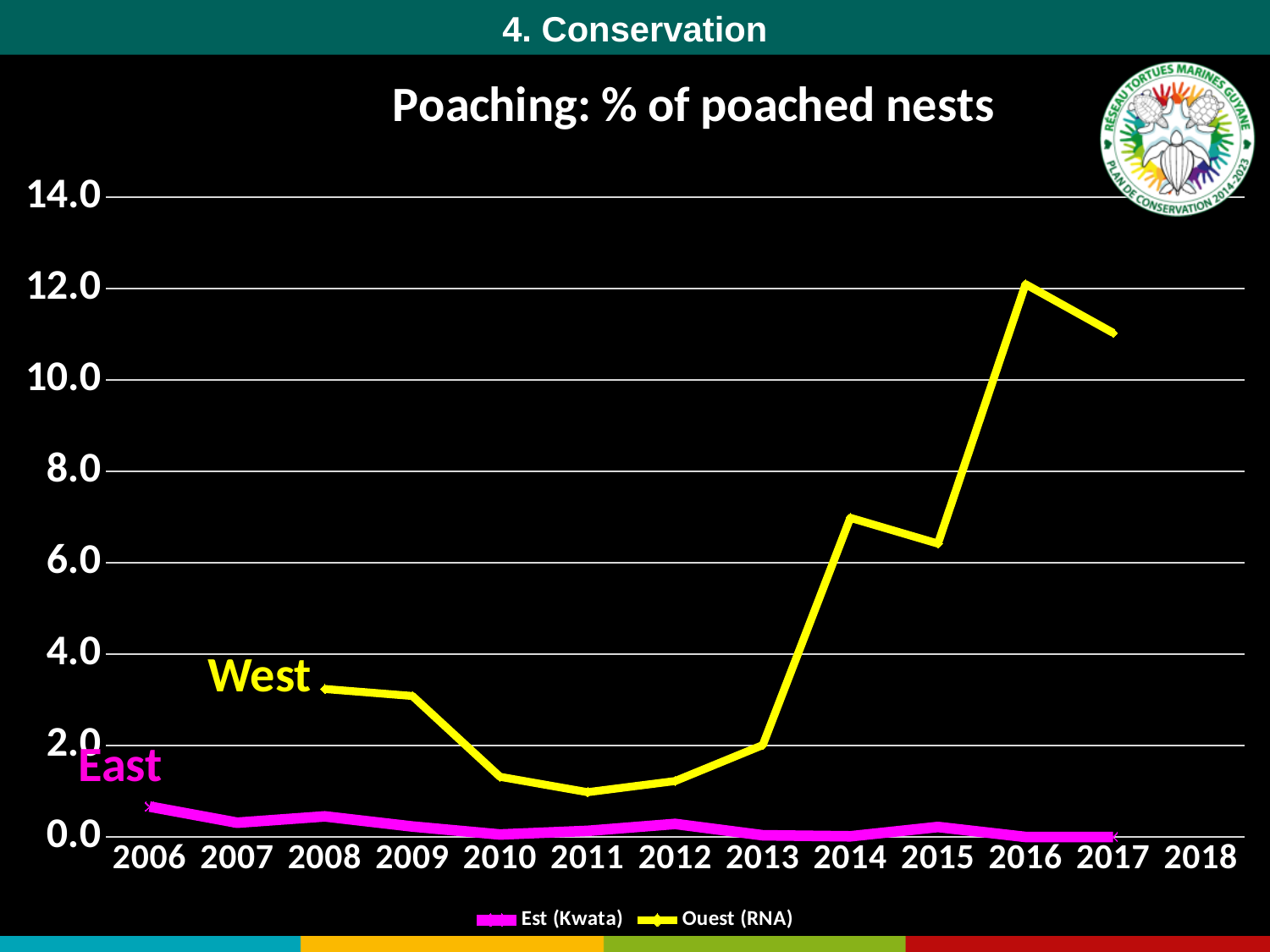
Which series has the larger value in 2016, Est (Kwata) or Ouest (RNA)? Ouest (RNA) Is the Ouest (RNA) value for 2016 greater or less than 10.0? greater In which year does the Ouest (RNA) series reach its lowest value? 2011 Is the Ouest (RNA) value for 2011 greater or less than 2.0? less How many series does the legend list? 2 What kind of chart is shown on the slide? line chart How many years are labelled on the x axis? 13 Does the Ouest (RNA) series rise or fall between 2013 and 2016? rise What colour is the line for the Est (Kwata) series? magenta In which year does the Ouest (RNA) series reach its highest value? 2016 Is the Ouest (RNA) value for 2014 greater or less than 6.0? greater What is the title of the chart? Poaching: % of poached nests